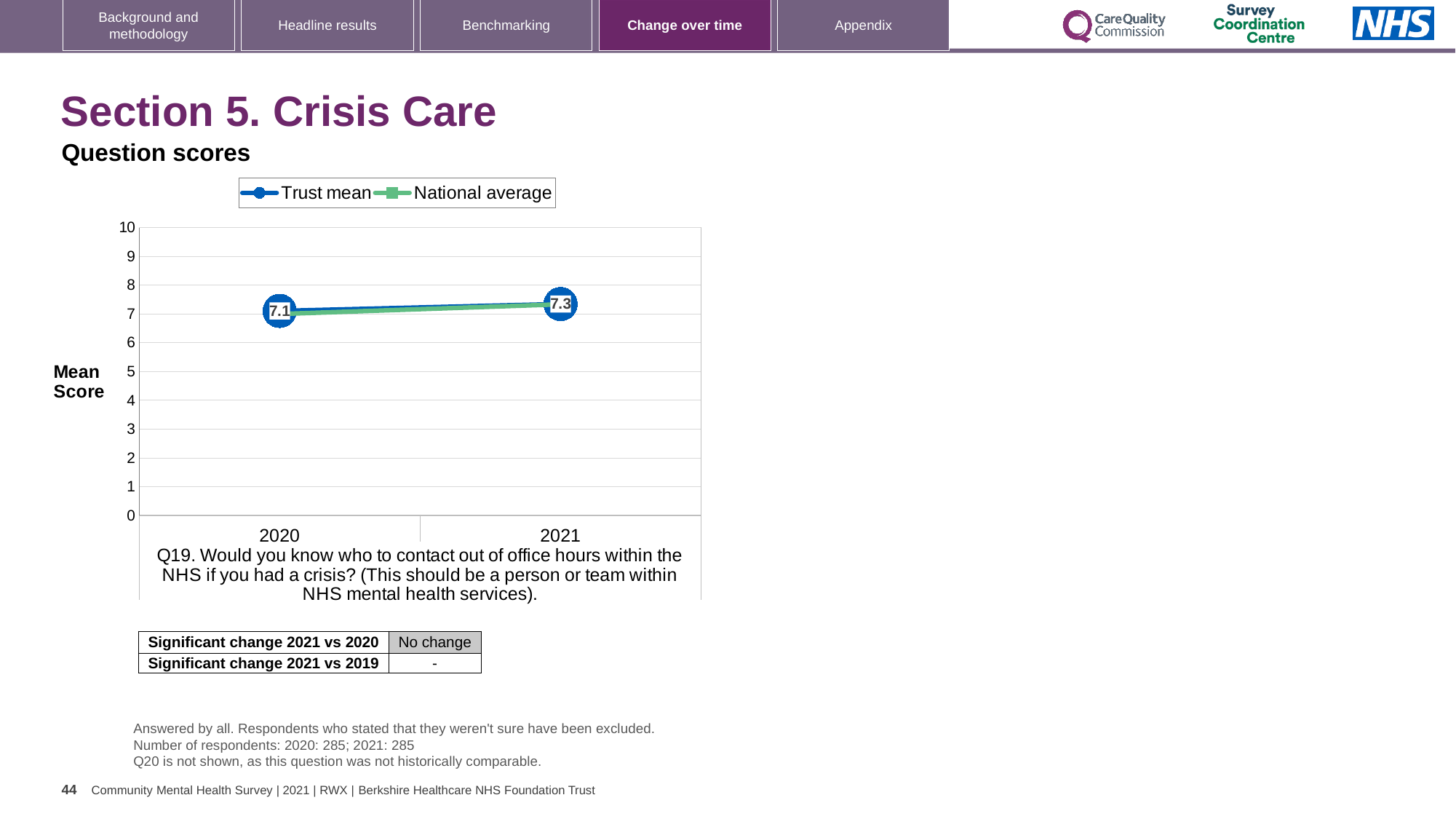
How many series does the chart legend list? 2 What is the Trust mean score for 2020? 7.1 Which year has the higher Trust mean score, 2020 or 2021? 2021 Does the Trust mean score rise or fall from 2020 to 2021? rise Is the Trust mean value for 2021 greater or less than 8? less In which year is the Trust mean score highest? 2021 What is the label on the y axis of the chart? Mean Score How many years are plotted on the x axis of the chart? 2 By how much did the Trust mean score change from 2020 to 2021? 0.2 What kind of chart is shown on the slide? line chart Is the National average value for 2020 greater or less than 5? greater What is the Trust mean score for 2021? 7.3